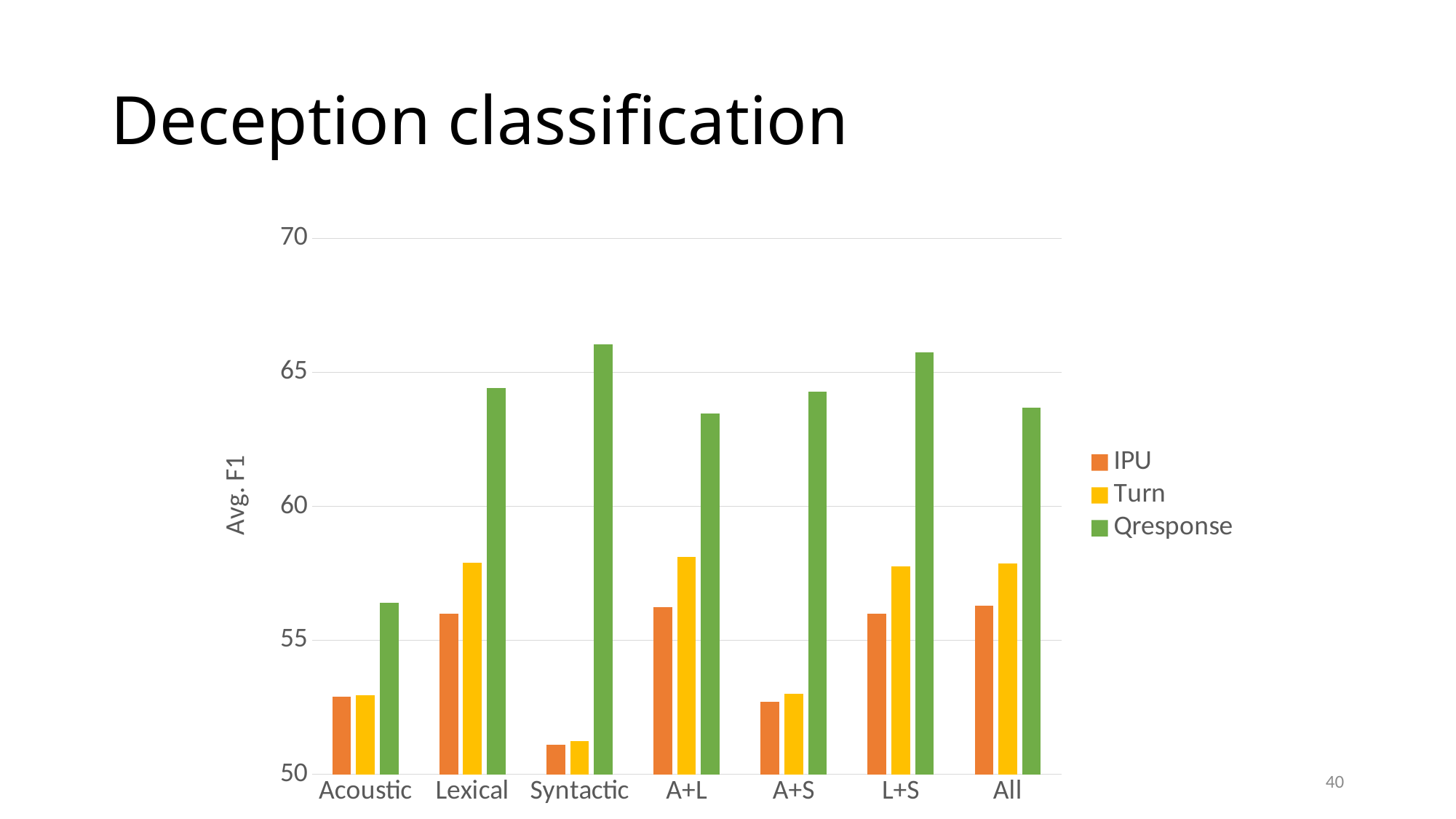
What is the label of the y axis? Avg. F1 For the Acoustic category, which is larger: the IPU value or the Qresponse value? Qresponse Is the Qresponse value for Syntactic greater or less than 65? greater Which series is shown in green? Qresponse Is the Turn value for A+S greater or less than 55? less Is the Qresponse value for Acoustic greater or less than 60? less Which category has the lowest IPU value? Syntactic What kind of chart is shown on the slide? bar chart How many feature-set categories are shown on the x axis? 7 Which category has the lowest Qresponse value? Acoustic How many series does the legend list? 3